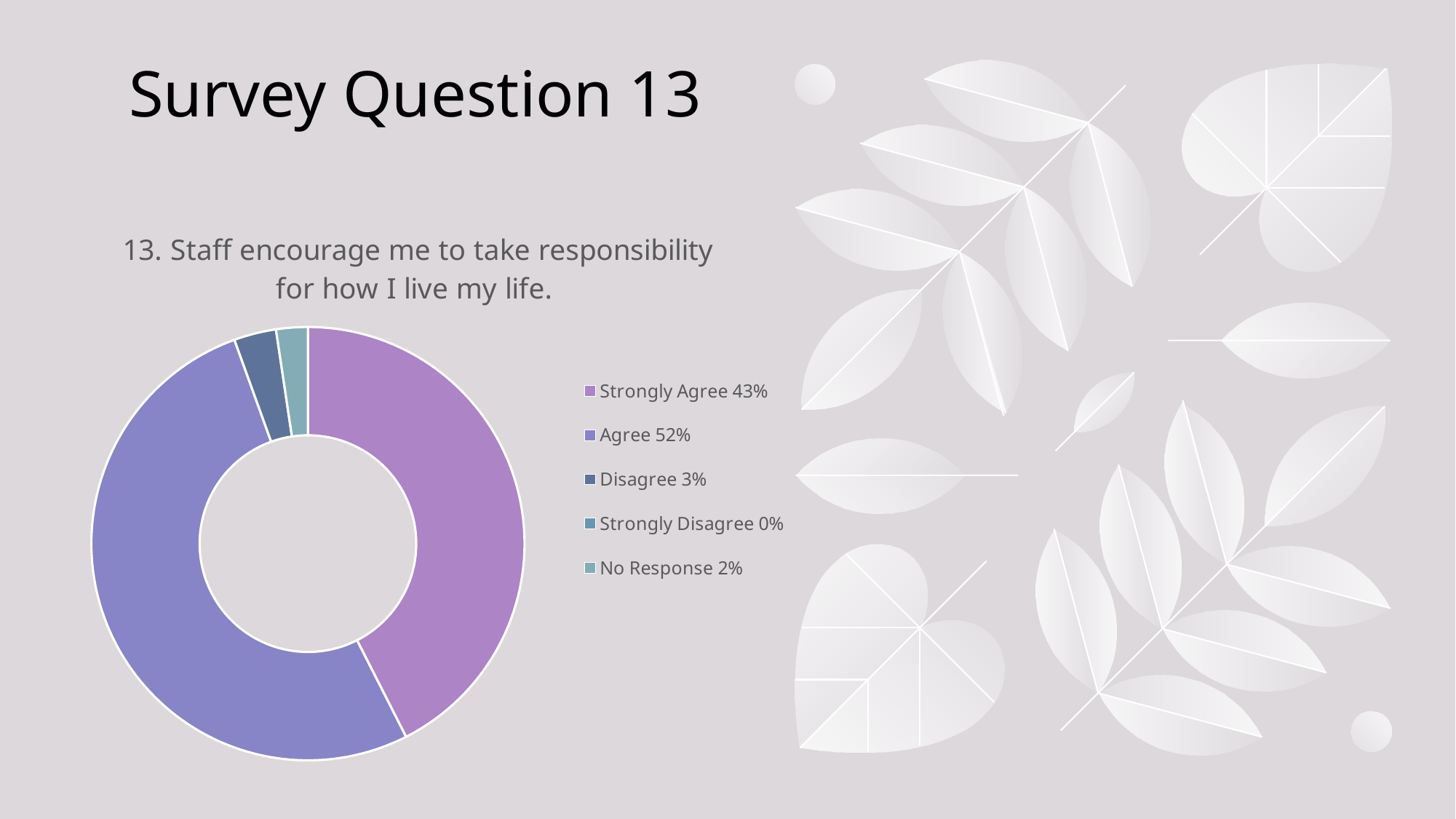
What percentage of respondents answered Disagree? 3% What percentage of respondents answered Strongly Disagree? 0% What is the title of the chart? 13. Staff encourage me to take responsibility for how I live my life. What percentage of respondents answered Agree? 52% How many response categories does the legend list? 5 Which response category has the largest share? Agree What percentage of respondents gave No Response? 2% Which response category has the smallest share? Strongly Disagree What is the difference between the Agree and Strongly Agree percentages? 9% Which is larger, the share for Disagree or the share for No Response? Disagree What kind of chart is shown on the slide? Pie chart (doughnut) What percentage of respondents answered Strongly Agree? 43%